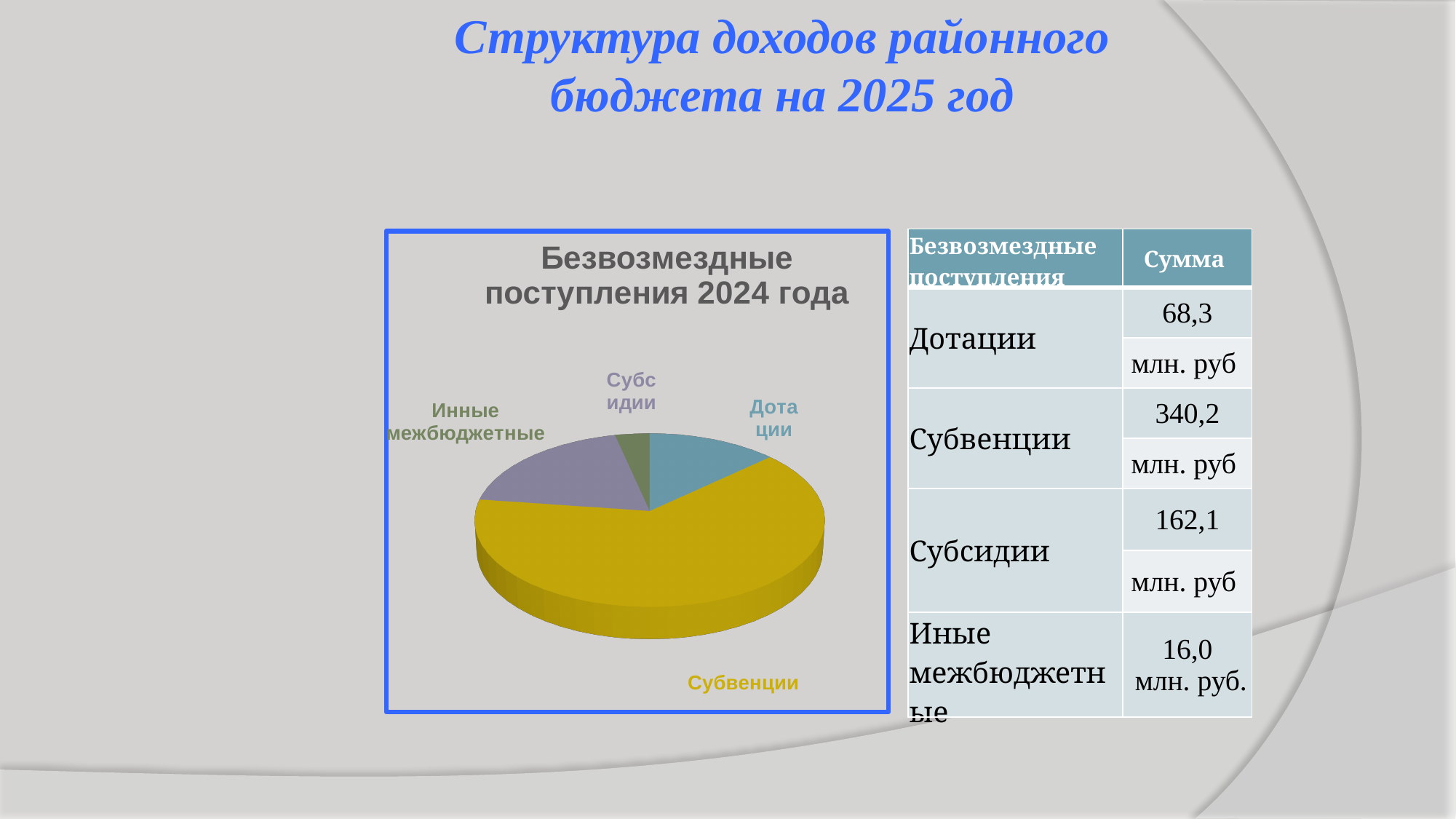
Which category has the largest slice in the pie chart? Субвенции Does the Субвенции slice take up more or less than half of the pie chart? More In the table next to the pie chart, what is the amount for Субсидии? 162,1 млн. руб What is the title of the pie chart? Безвозмездные поступления 2024 года In the table next to the pie chart, what is the amount for Субвенции? 340,2 млн. руб In the table next to the pie chart, what is the amount for Дотации? 68,3 млн. руб In the table next to the pie chart, what is the amount for Иные межбюджетные? 16,0 млн. руб. What kind of chart is shown on the slide? Pie chart Which slice is larger in the pie chart, Субвенции or Иные межбюджетные? Субвенции Which slice is larger in the pie chart, Субвенции or Дотации? Субвенции How many slices does the pie chart have? 4 What colour is the Субвенции slice in the pie chart? Yellow